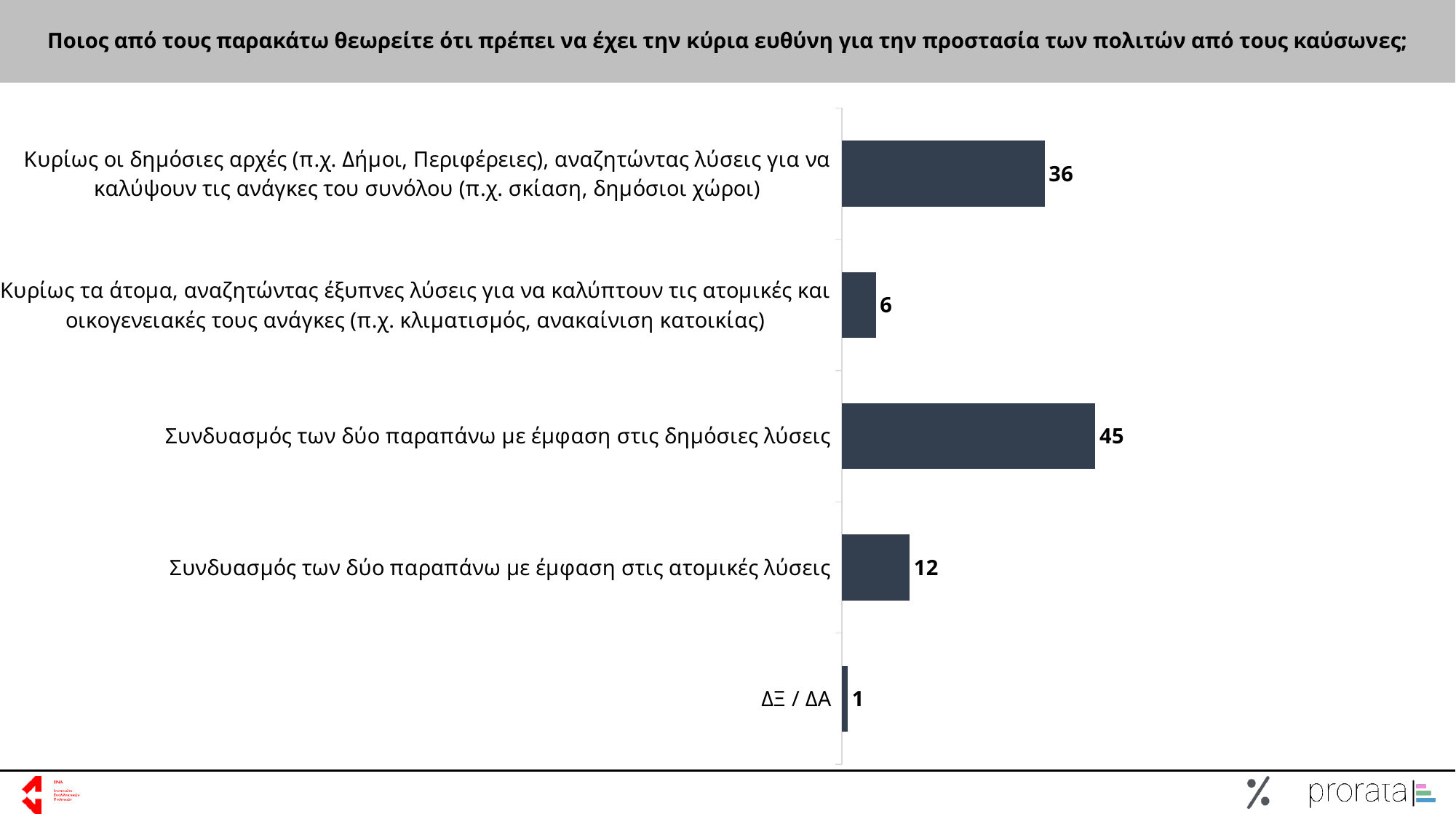
What is the title of the chart on the slide? Ποιος από τους παρακάτω θεωρείτε ότι πρέπει να έχει την κύρια ευθύνη για την προστασία των πολιτών από τους καύσωνες; What value is shown for the category 'ΔΞ / ΔΑ'? 1 What value is shown for the category 'Συνδυασμός των δύο παραπάνω με έμφαση στις δημόσιες λύσεις'? 45 Which category has the highest value? Συνδυασμός των δύο παραπάνω με έμφαση στις δημόσιες λύσεις Which is larger: the value for the category beginning 'Κυρίως οι δημόσιες αρχές' or the value for 'Συνδυασμός των δύο παραπάνω με έμφαση στις ατομικές λύσεις'? Κυρίως οι δημόσιες αρχές What is the difference between the value for 'Συνδυασμός των δύο παραπάνω με έμφαση στις δημόσιες λύσεις' and the value for the category beginning 'Κυρίως οι δημόσιες αρχές'? 9 Which category has the lowest value? ΔΞ / ΔΑ What is the difference between the value for 'Συνδυασμός των δύο παραπάνω με έμφαση στις ατομικές λύσεις' and the value for the category beginning 'Κυρίως τα άτομα'? 6 How many categories are shown in the chart? 5 What value is shown for the category 'Συνδυασμός των δύο παραπάνω με έμφαση στις ατομικές λύσεις'? 12 What value is shown for the category beginning 'Κυρίως τα άτομα, αναζητώντας έξυπνες λύσεις'? 6 What kind of chart is shown on the slide? Bar chart